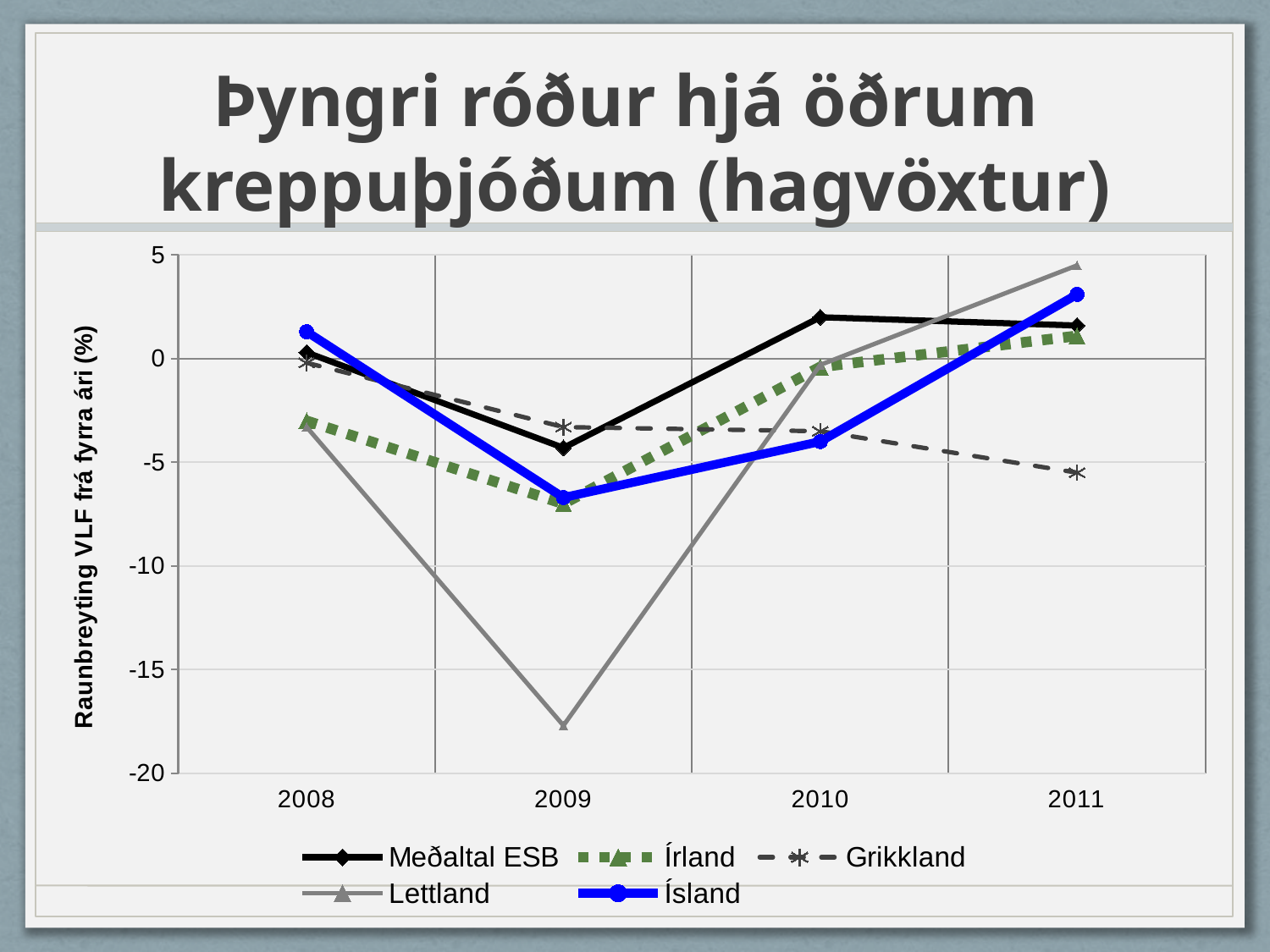
Is the value for Lettland in 2009 greater or less than -15? less Is the value for Ísland in 2009 greater or less than -5? less How many series does the legend list? 5 Which series has the highest value in 2011? Lettland Which is larger in 2011, the value for Lettland or the value for Grikkland? Lettland What kind of chart is shown on the slide? line chart Is the value for Meðaltal ESB in 2010 greater or less than 0? greater How many years are plotted along the x axis? 4 Which series has the lowest value in 2009? Lettland Does the Grikkland series rise or fall from 2008 to 2011? fall Which is larger in 2010, the value for Meðaltal ESB or the value for Ísland? Meðaltal ESB What is the label on the vertical axis? Raunbreyting VLF frá fyrra ári (%)